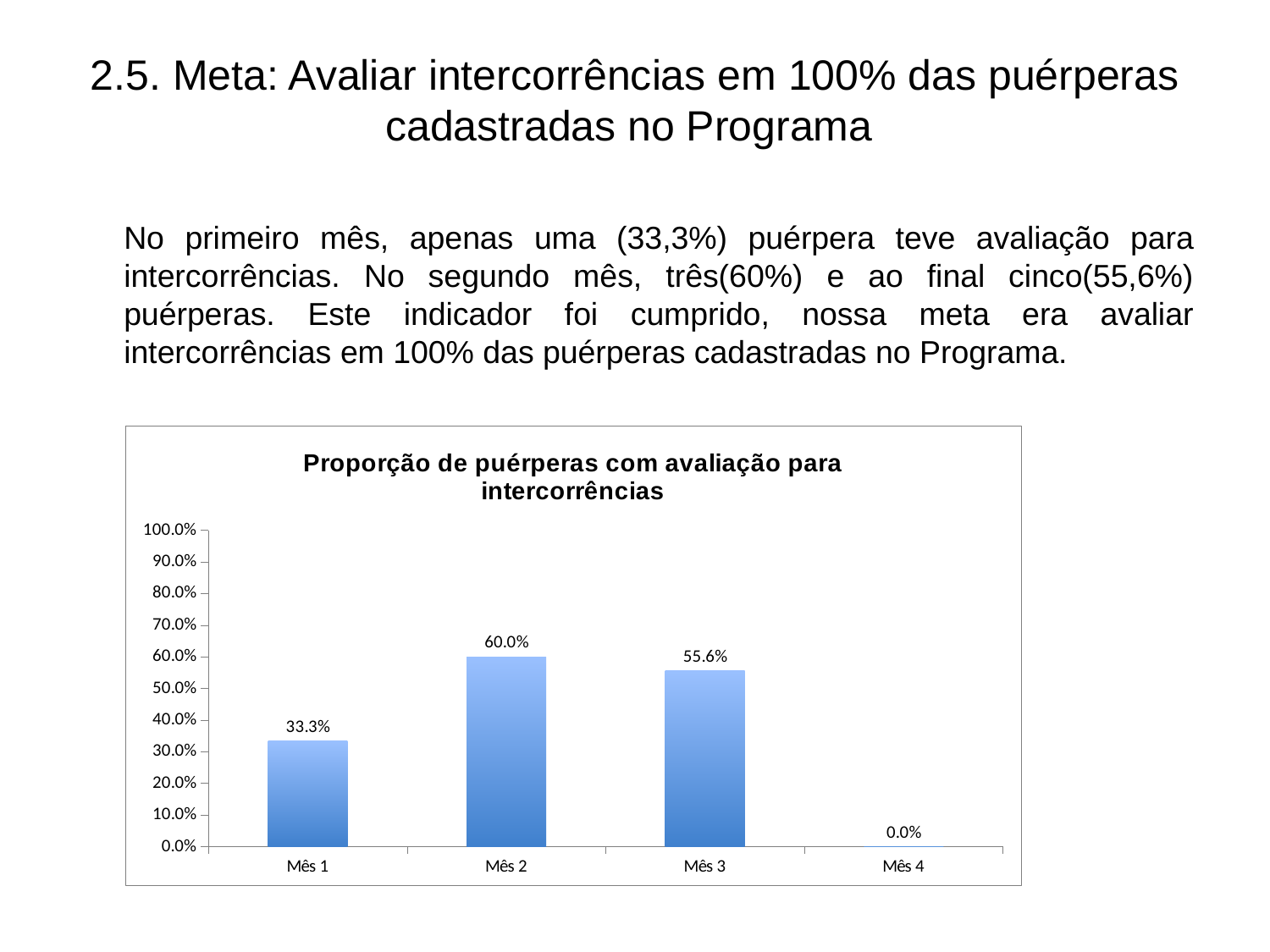
What is the value for Mês 1? 33.3% Is the value for Mês 1 greater or less than 40.0%? less Which month has the highest value? Mês 2 What is the value for Mês 2? 60.0% Which month has the lowest value? Mês 4 How many months are shown on the x axis? 4 What is the difference between the values for Mês 2 and Mês 1? 26.7% What is the value for Mês 3? 55.6% What kind of chart is shown? bar chart What is the title of the chart? Proporção de puérperas com avaliação para intercorrências What is the value for Mês 4? 0.0% Which is larger, the value for Mês 2 or the value for Mês 3? Mês 2